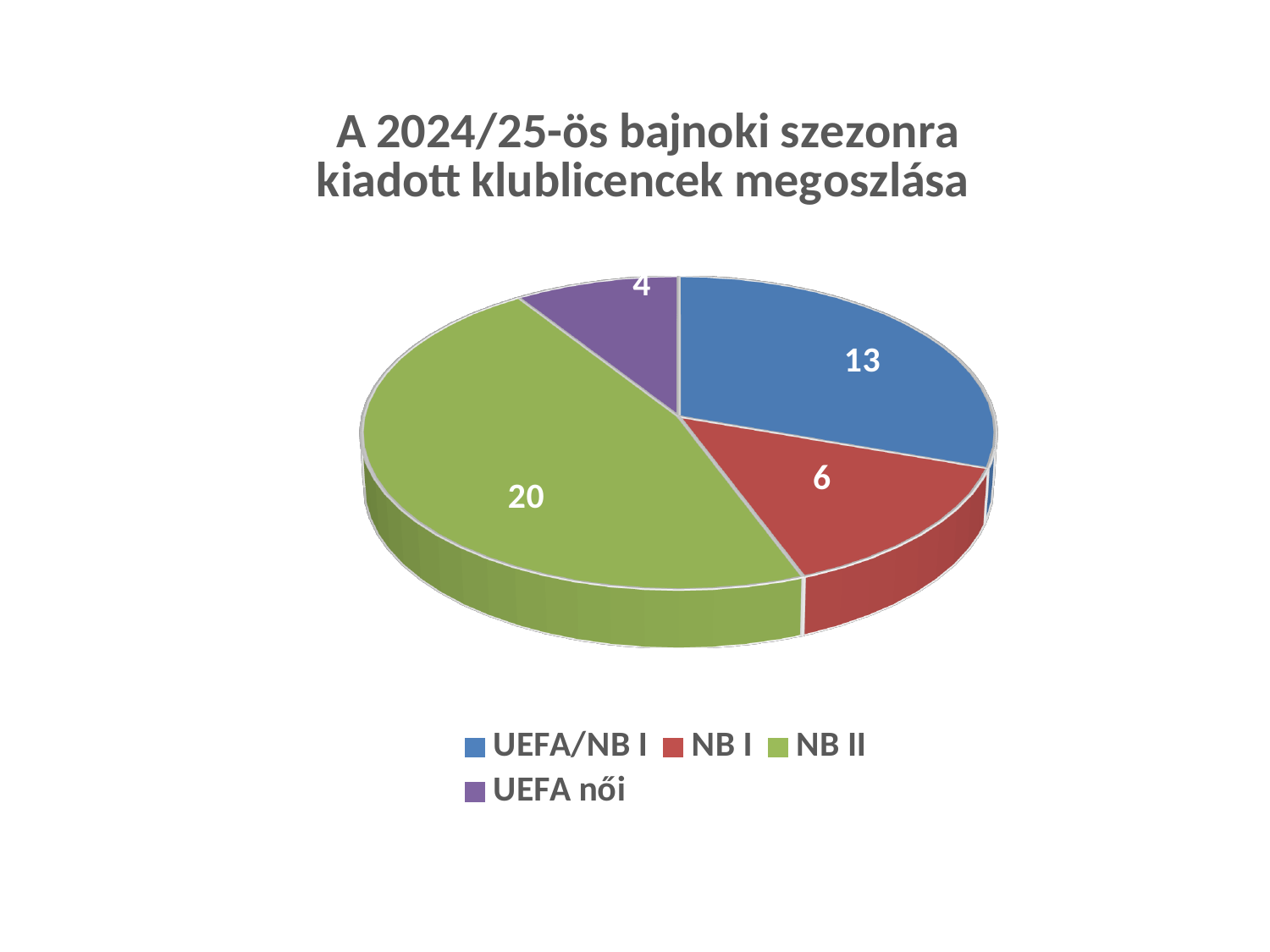
What is the value for NB I? 6 What is the value for NB II? 20 What is the difference between the values for NB II and UEFA/NB I? 7 What kind of chart is shown on the slide? pie chart Which is larger, the value for UEFA/NB I or the value for NB I? UEFA/NB I What is the value for UEFA/NB I? 13 What is the value for UEFA női? 4 Which category has the largest slice? NB II How many categories does the pie chart show? 4 Which category has the smallest slice? UEFA női What is the title of the chart? A 2024/25-ös bajnoki szezonra kiadott klublicencek megoszlása What is the difference between the values for NB I and UEFA női? 2